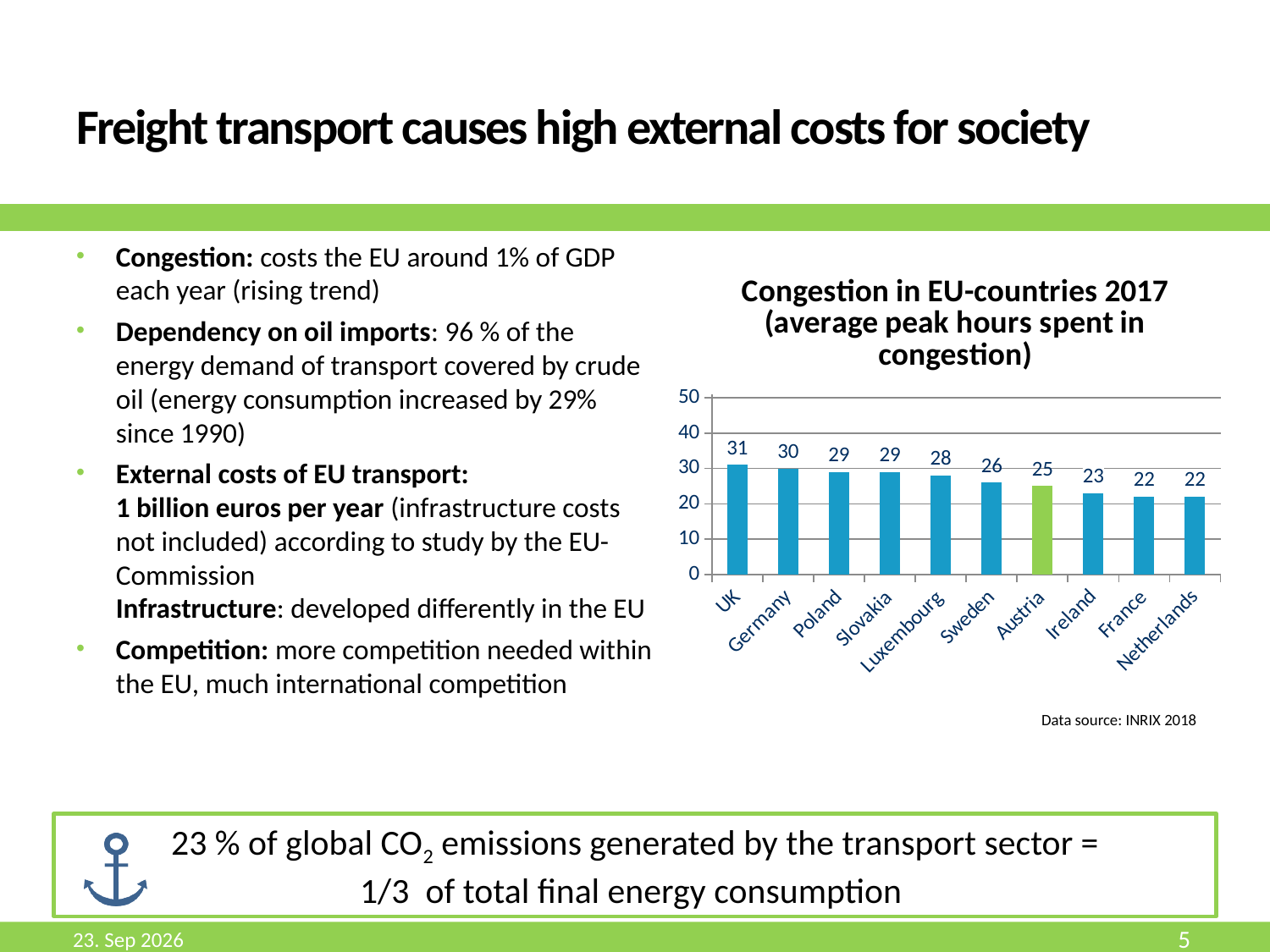
What kind of chart is shown on the slide? bar chart Which country's bar is coloured green instead of blue? Austria What is the title of the chart? Congestion in EU-countries 2017 (average peak hours spent in congestion) Is the value for Ireland greater or less than 30? less What is the value for Luxembourg in the chart? 28 How many countries are shown in the chart? 10 Which country has the highest value in the chart? UK Do the values rise or fall from left to right along the x axis? fall Which has a larger value, Germany or Sweden? Germany What is the value for Austria in the chart? 25 What is the difference between the values for UK and Netherlands? 9 What is the difference between the values for Poland and Austria? 4